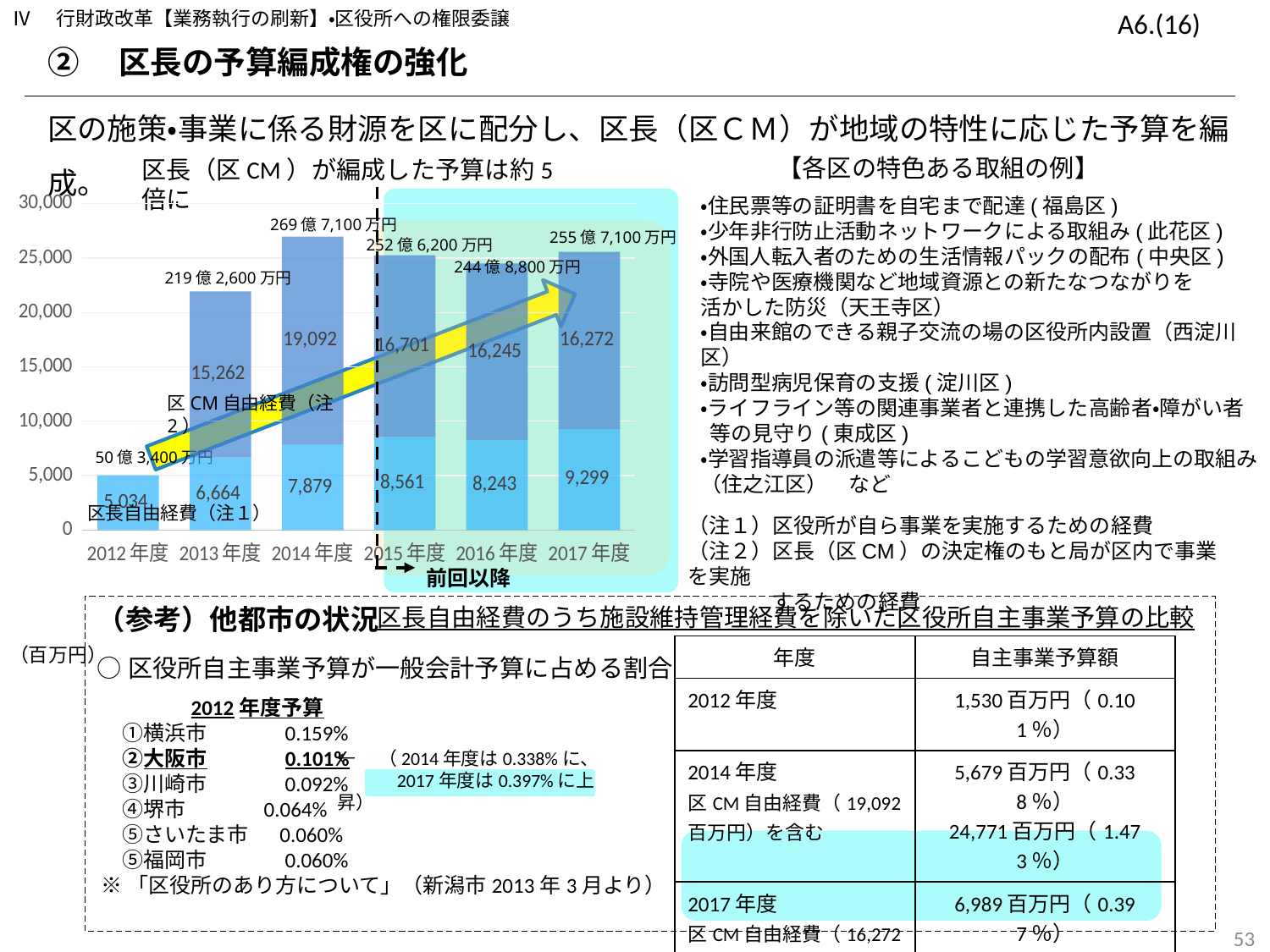
What is the value of 区長自由経費 for 2014年度 in the bar chart? 7,879 What total is labelled above the 2017年度 bar in the chart? 255億7,100万円 What is the difference between the 区長自由経費 values for 2017年度 and 2016年度 in the bar chart? 1,056 How many fiscal years are shown on the x axis of the bar chart? 6 Which year has the highest 区CM自由経費 value in the bar chart? 2014年度 Is the total height of the 2013年度 bar in the chart greater or less than 20,000? greater What kind of chart is used to show the 区長 budget by fiscal year? Stacked bar chart What is the title text above the bar chart? 区長（区CM）が編成した予算は約5倍に In the bar chart, which is larger: the 区CM自由経費 value for 2015年度 or for 2016年度? 2015年度 Which year has the lowest 区長自由経費 value in the bar chart? 2012年度 What total is labelled above the 2012年度 bar in the chart? 50億3,400万円 What is the value of 区CM自由経費 for 2013年度 in the bar chart? 15,262